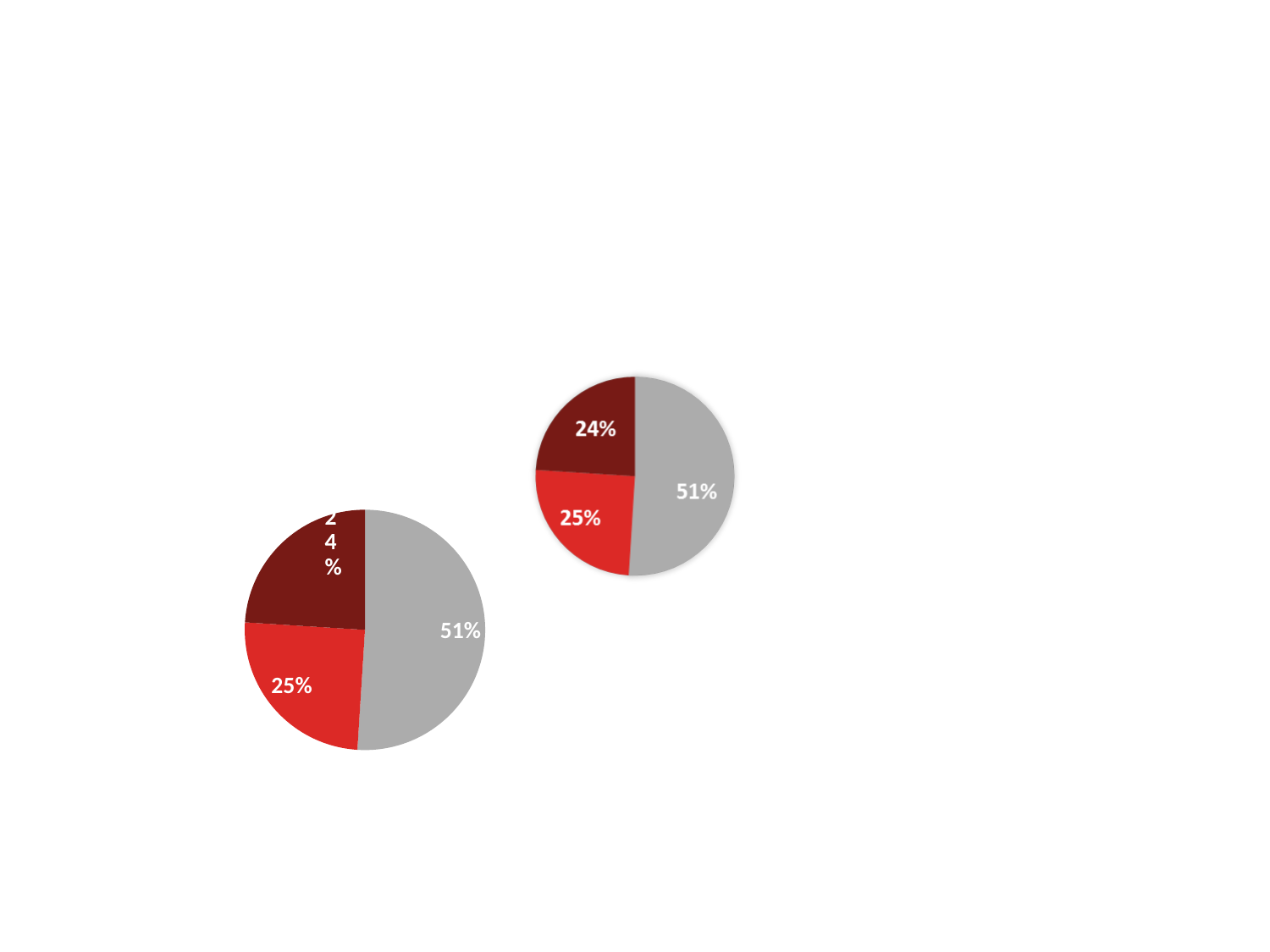
How many slices does the lower-left pie chart have? 3 How many pie charts are shown on the slide? 2 In the upper-right pie chart, what share does the grey slice represent? 51% What kind of chart is the smaller chart at the upper right of the slide? Pie chart In the lower-left pie chart, what is the difference between the grey slice and the bright red slice? 26% In the lower-left pie chart, what share does the bright red slice represent? 25% In the lower-left pie chart, what share does the dark red slice represent? 24% How many slices does the upper-right pie chart have? 3 What kind of chart is the larger chart at the lower left of the slide? Pie chart In the upper-right pie chart, which colour slice is the largest? Grey